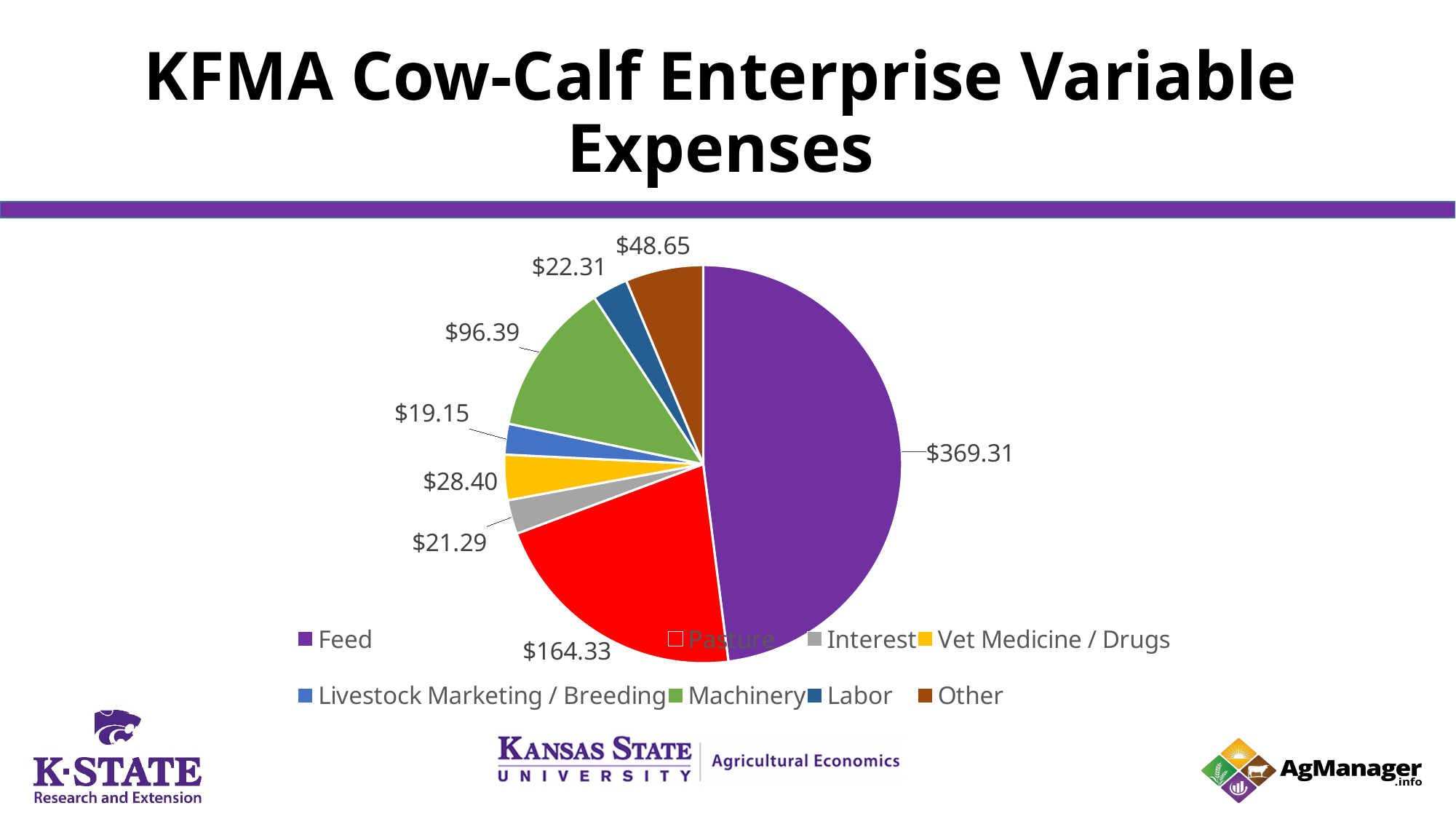
What is the value for Feed? $369.31 Which expense category has the smallest value? Livestock Marketing / Breeding How many expense categories does the pie chart show? 8 What is the value for Vet Medicine / Drugs? $28.40 What is the difference between the Feed value and the Pasture value? $204.98 What is the value for Machinery? $96.39 Which expense category has the largest value? Feed What type of chart is shown on the slide? Pie chart What is the title of the chart on the slide? KFMA Cow-Calf Enterprise Variable Expenses Which is larger, the value for Machinery or the value for Other? Machinery What is the value for Labor? $22.31 What is the value for Pasture? $164.33